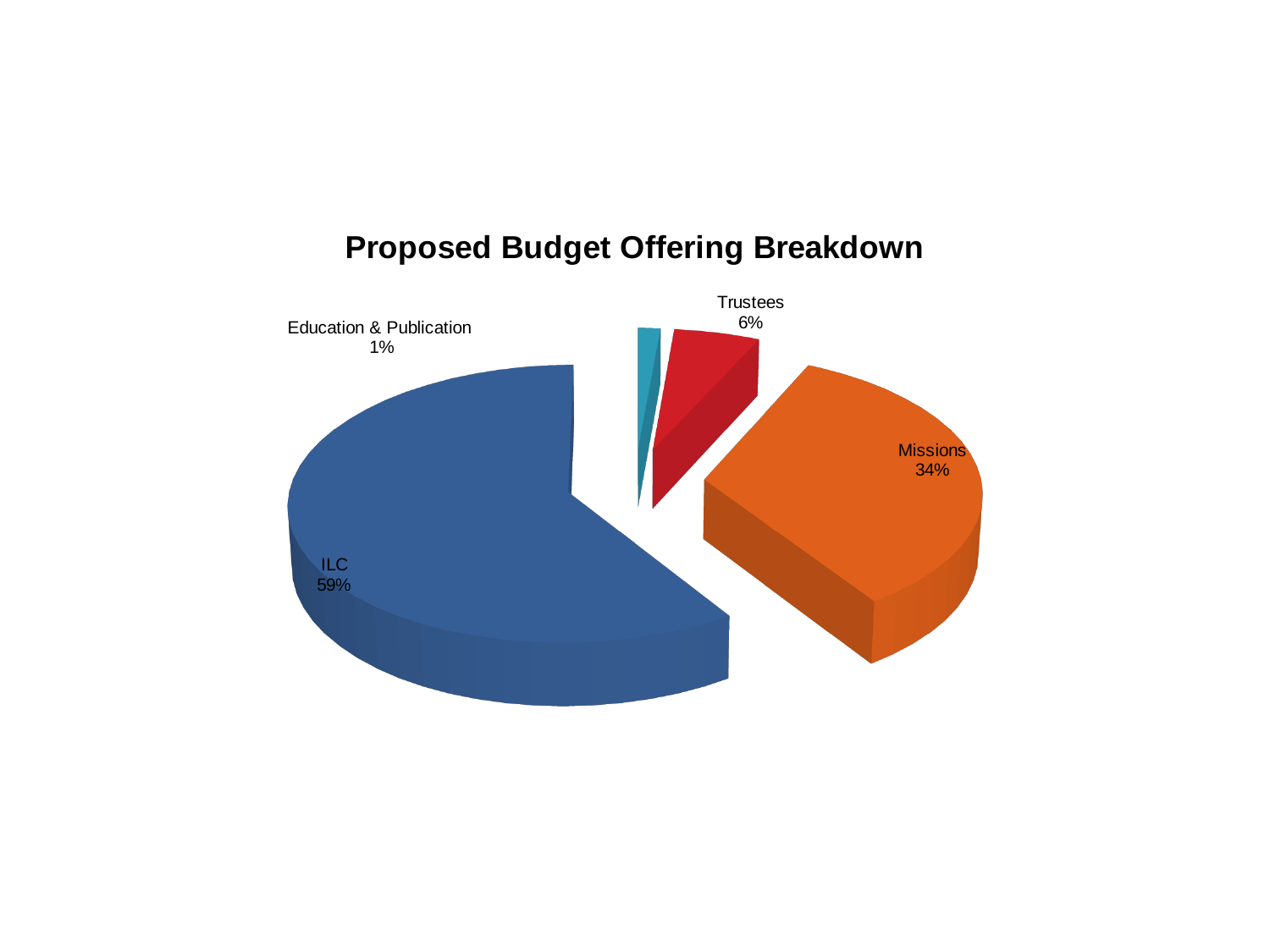
What share of the proposed budget offering goes to Missions? 34% What colour is the Missions slice? Orange What share of the proposed budget offering goes to ILC? 59% What is the title of the chart? Proposed Budget Offering Breakdown What is the difference in percentage points between the ILC share and the Missions share? 25 Which category has the smallest share of the pie? Education & Publication Which is larger, the share for Trustees or the share for Education & Publication? Trustees How many categories are shown in the pie chart? 4 Which category has the largest share of the pie? ILC What share of the proposed budget offering goes to Trustees? 6% What kind of chart is shown on the slide? Pie chart